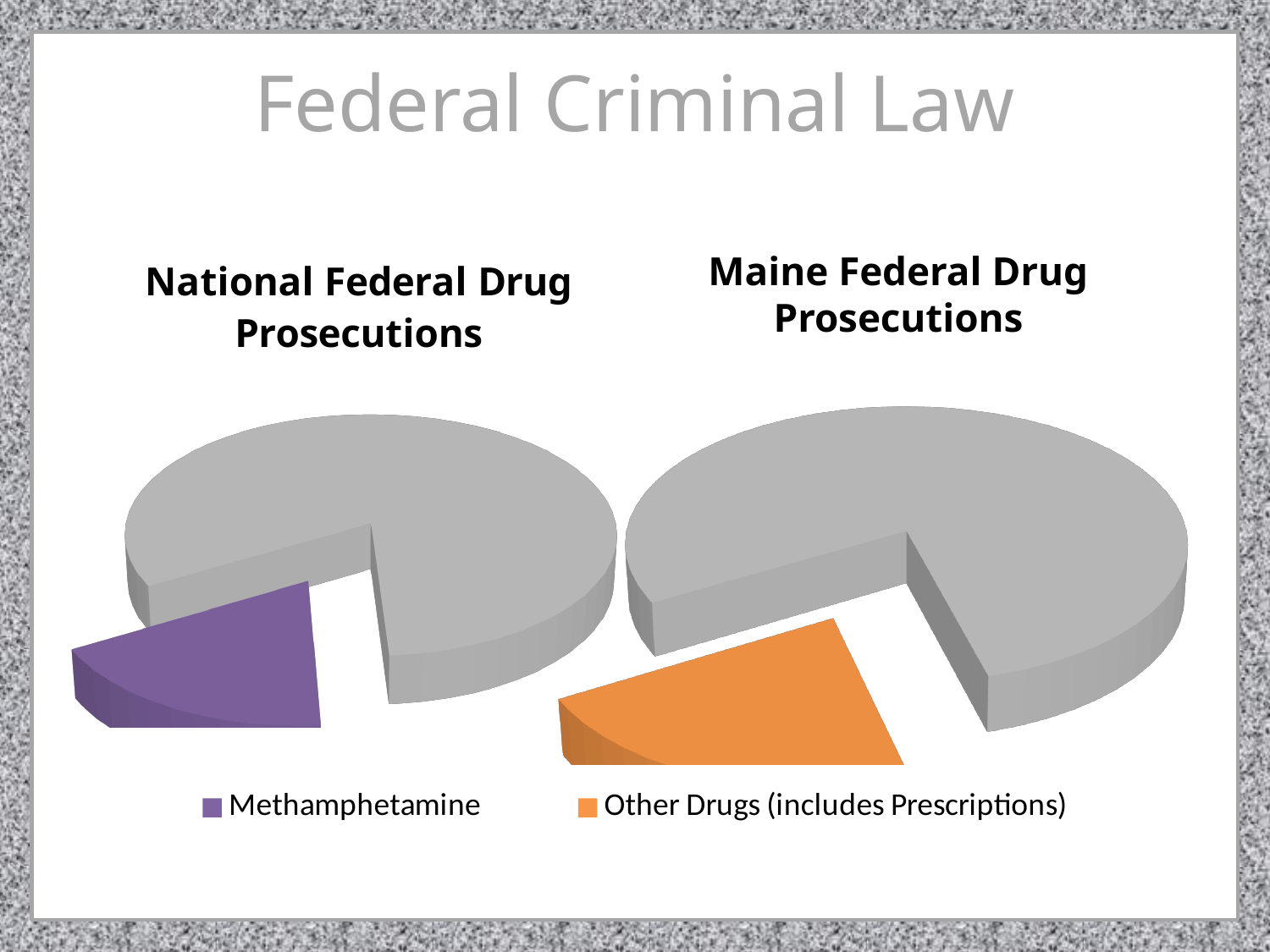
In the Maine Federal Drug Prosecutions chart, is the grey slice more or less than half of the pie? more How many slices does the Maine Federal Drug Prosecutions pie have? 2 What is the title of the chart on the right side of the slide? Maine Federal Drug Prosecutions How many pie charts are shown on the slide? 2 What kind of chart is the National Federal Drug Prosecutions chart? pie chart In the Maine Federal Drug Prosecutions chart, is the orange slice larger or smaller than the grey slice? smaller What colour does the legend assign to Methamphetamine? purple In the National Federal Drug Prosecutions chart, is the purple slice more or less than half of the pie? less How many entries does the shared legend list? 2 What kind of chart is the Maine Federal Drug Prosecutions chart? pie chart How many slices does the National Federal Drug Prosecutions pie have? 2 In the National Federal Drug Prosecutions chart, is the purple (Methamphetamine) slice larger or smaller than the grey slice? smaller